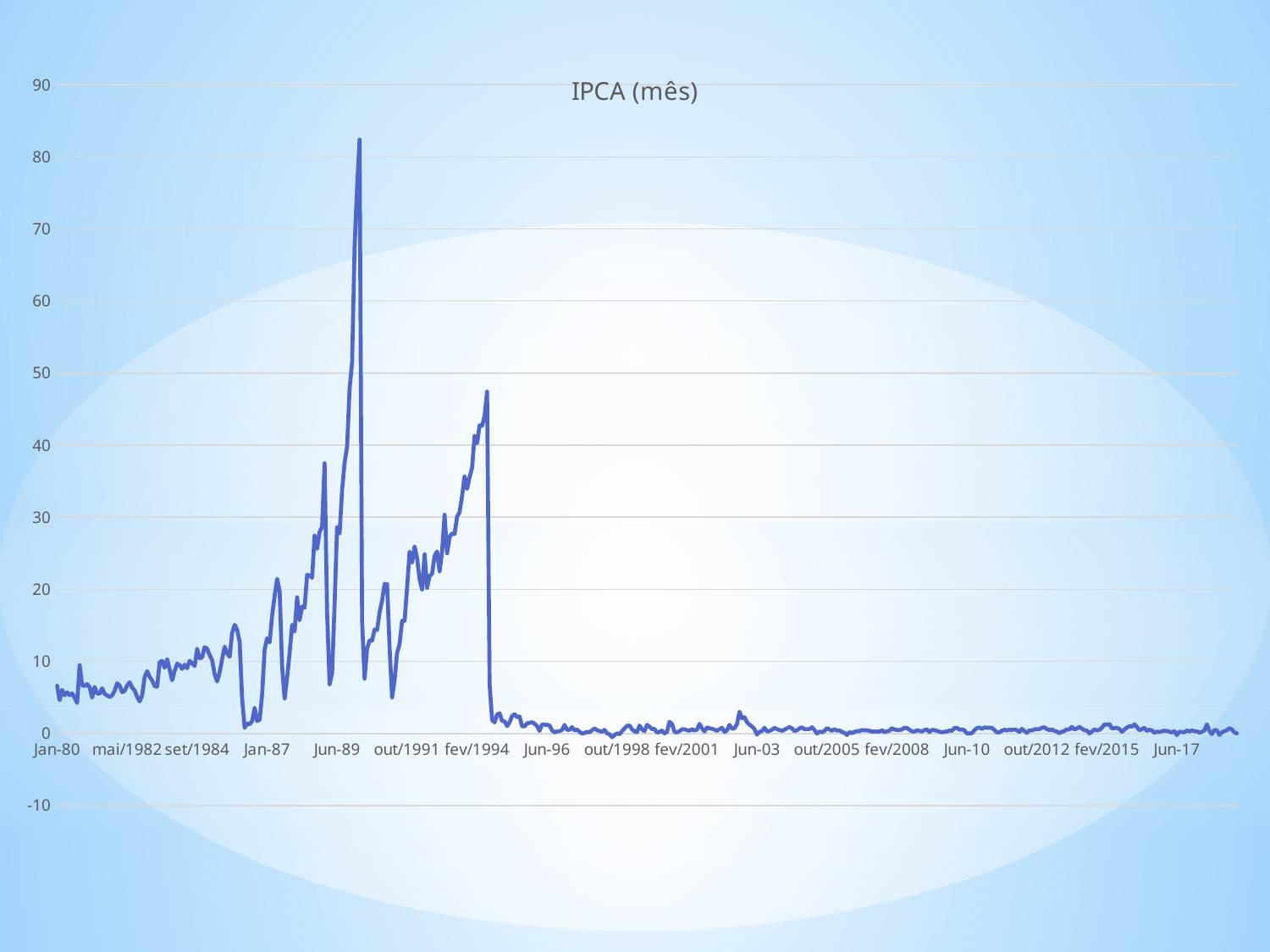
Which is larger, the value around Jun-89 or the value around Jun-96? Jun-89 Is the value at out/2005 greater or less than 10? less How many labelled tick marks are shown on the x axis? 17 What is the highest value labelled on the y axis? 90 Is the highest value of the line, reached around Jun-89, greater or less than 70? greater Is the value at Jan-80 greater or less than 10? less What kind of chart is shown on the slide? line chart Does the line generally rise or fall between fev/1994 and Jun-96? fall Does the line generally rise or fall between Jan-80 and Jun-89? rise What is the title of the chart? IPCA (mês)